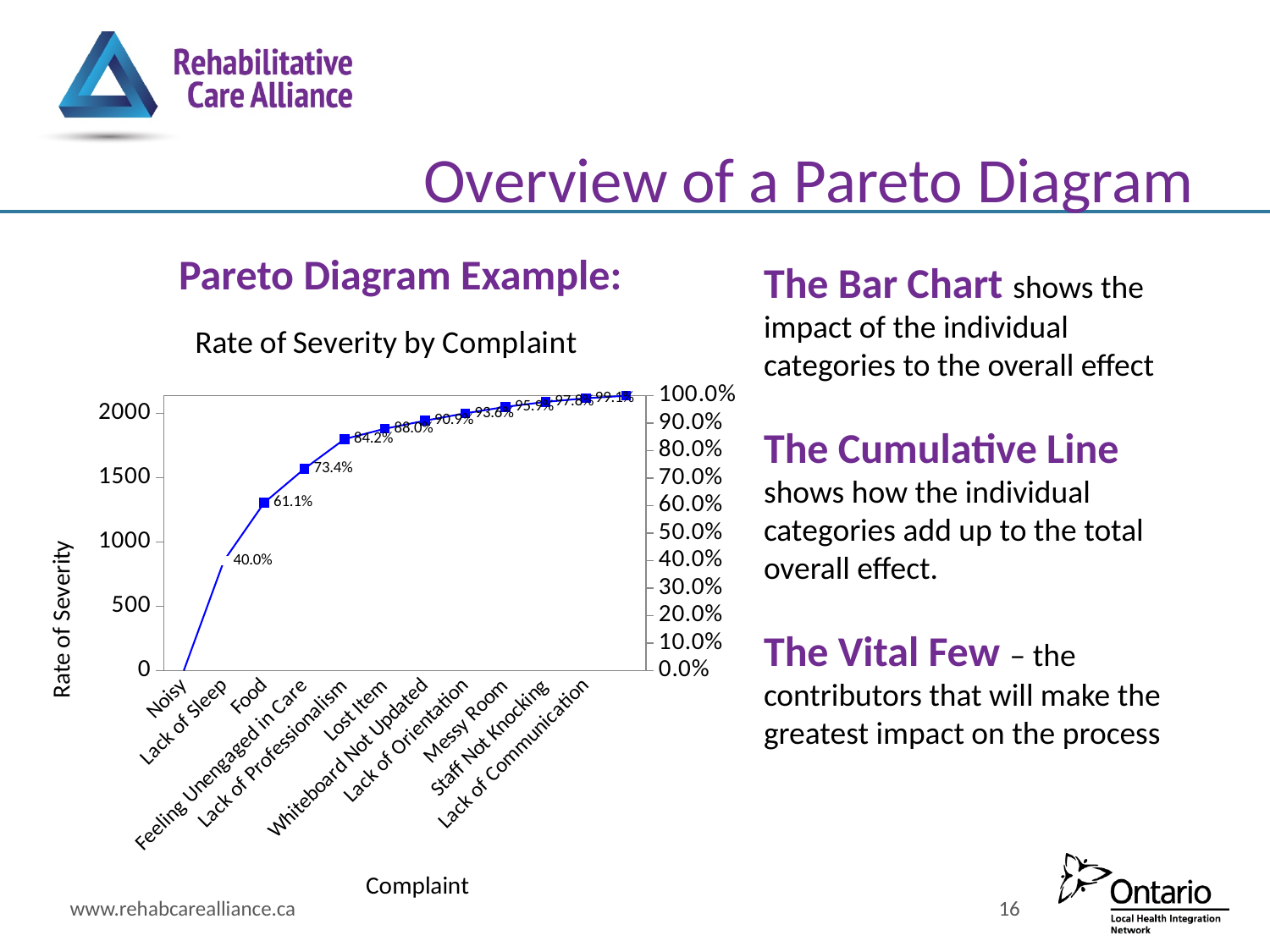
What is the title of the chart on the slide? Rate of Severity by Complaint Does the cumulative line in the chart rise or fall from left to right along the x axis? rise What kind of chart is visibly plotted on the slide? line chart What is the label of the left vertical axis of the chart? Rate of Severity What is the difference between the second (61.1%) and first (40.0%) cumulative percentage labels on the line? 21.1% What is the second cumulative percentage data label shown on the line in the chart? 61.1% Is the cumulative percentage at the fourth labelled point (84.2%) greater or less than 80.0%? greater What is the first cumulative percentage data label shown on the line in the chart? 40.0% What is the highest cumulative percentage data label readable on the line in the chart? 99.1% Which is larger, the cumulative label 84.2% or the cumulative label 73.4%? 84.2% What is the third cumulative percentage data label shown on the line in the chart? 73.4% How many complaint categories are listed along the x axis of the chart? 11